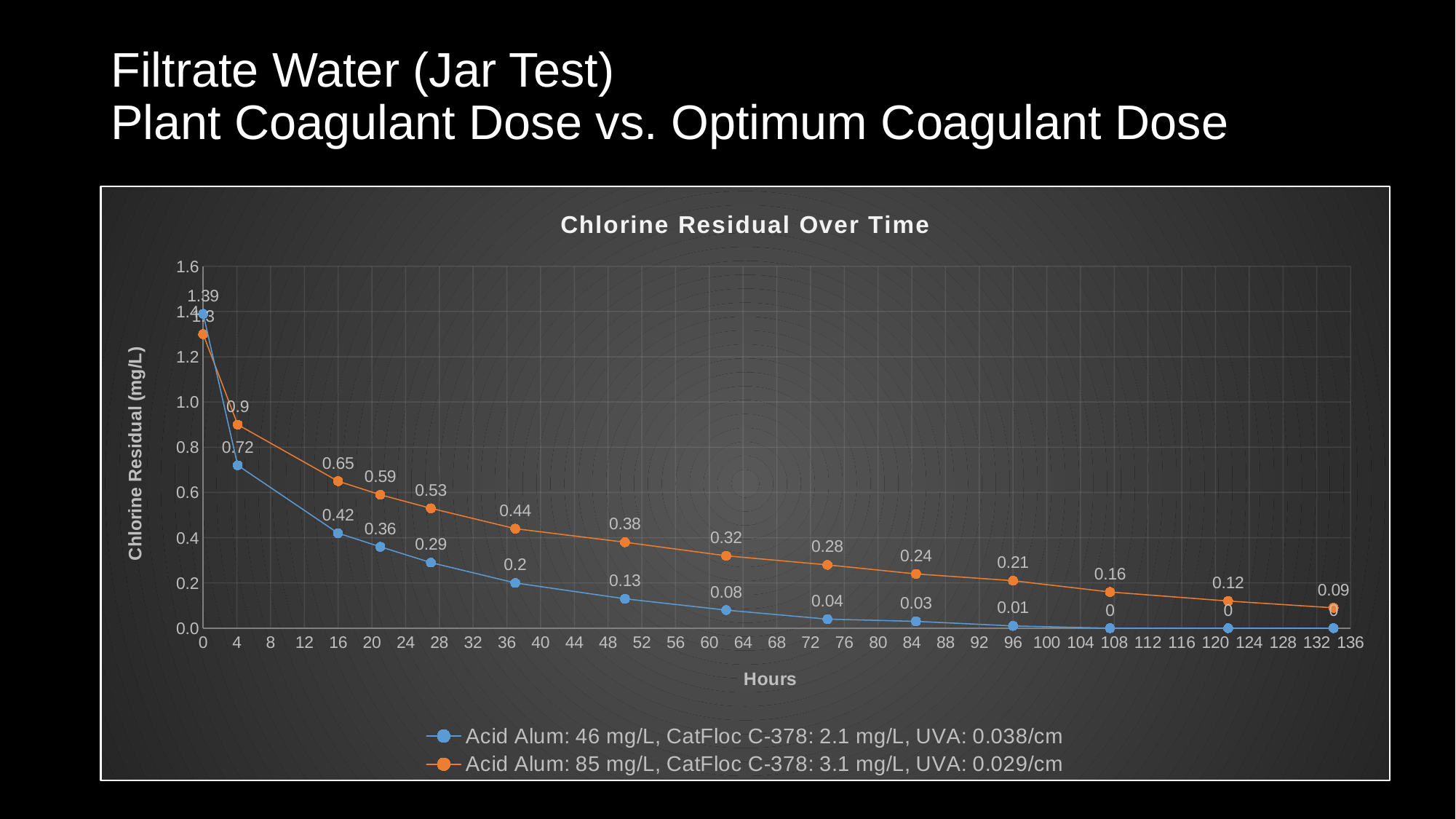
At 4 hours, which series has the higher chlorine residual? Acid Alum: 85 mg/L, CatFloc C-378: 3.1 mg/L, UVA: 0.029/cm How many series does the legend list? 2 At 4 hours, what is the difference between the Acid Alum: 85 mg/L value and the Acid Alum: 46 mg/L value? 0.18 How many data points are plotted for the Acid Alum: 46 mg/L series? 14 Do the chlorine residual values rise or fall as hours increase? fall What is the chlorine residual value at 4 hours for the Acid Alum: 85 mg/L series? 0.9 What is the title of the chart? Chlorine Residual Over Time What is the chlorine residual value at 4 hours for the Acid Alum: 46 mg/L series? 0.72 What is the first (0 hours) chlorine residual value for the Acid Alum: 46 mg/L series? 1.39 What is the last plotted value for the Acid Alum: 85 mg/L series? 0.09 What is the last plotted value for the Acid Alum: 46 mg/L series? 0 What kind of chart is shown on the slide? line chart